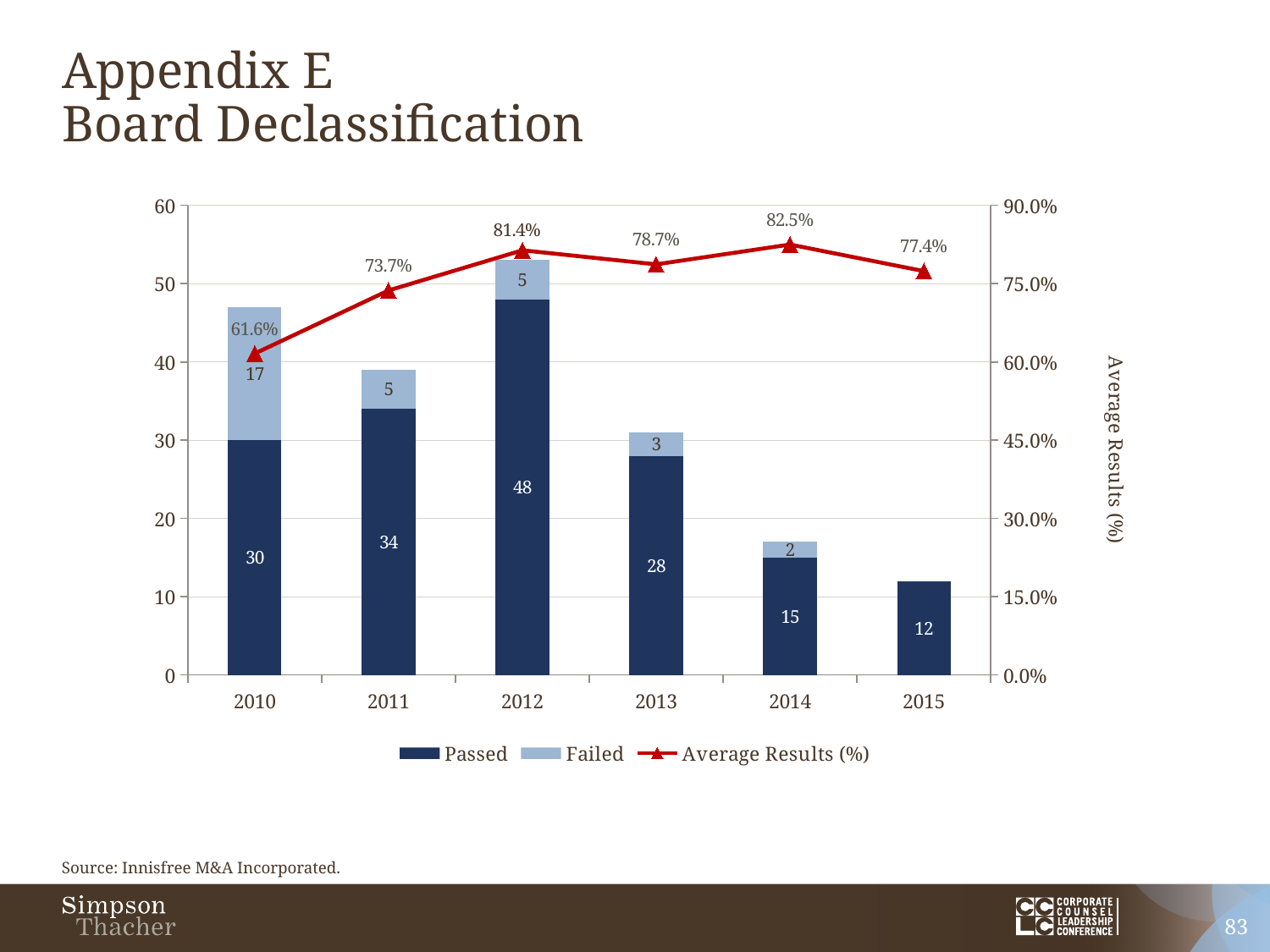
What is the label of the right-hand vertical axis? Average Results (%) Which is larger, the Failed value for 2010 or the Failed value for 2011? 2010 Which year had the highest number of Passed proposals? 2012 How many years are shown on the x axis? 6 What is the total of the stacked bar for 2012 (Passed plus Failed)? 53 Did the number of Passed proposals rise or fall from 2012 to 2015? fall How many Passed proposals were there in 2012? 48 What is the difference between the Passed values for 2011 and 2013? 6 How many Failed proposals were there in 2010? 17 How many series does the legend list? 3 Which year had the lowest Average Results (%)? 2010 What was the Average Results (%) value in 2014? 82.5%